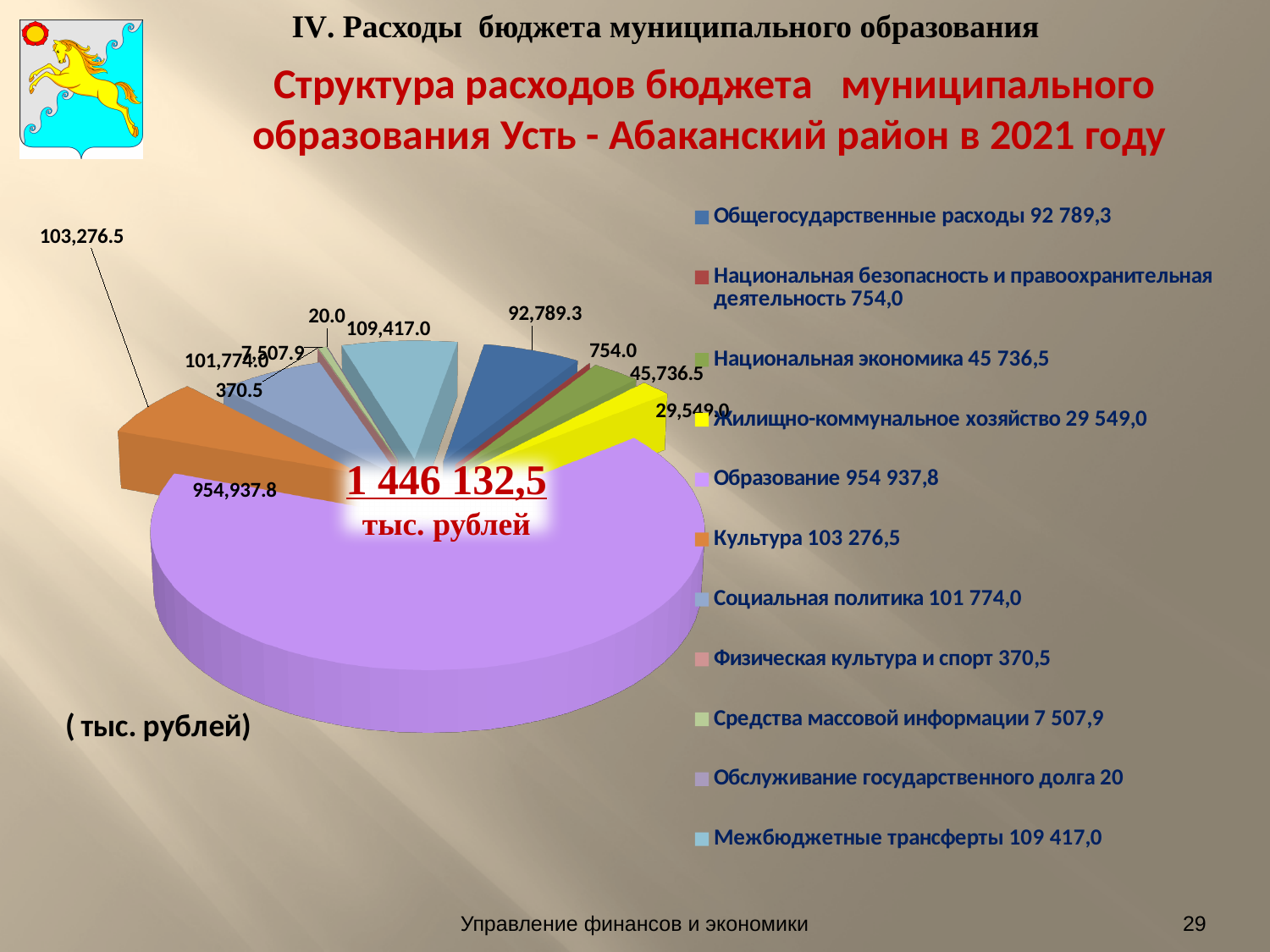
Which category has the largest slice of the pie chart? Образование What kind of chart is shown on the slide? Pie chart How many categories (slices) does the pie chart have? 11 What is the value for Образование in the pie chart? 954,937.8 What is the value for Межбюджетные трансферты in the pie chart? 109,417.0 What is the difference between the values for Межбюджетные трансферты and Общегосударственные расходы? 16,627.7 Which category has the smallest value in the pie chart? Обслуживание государственного долга What is the value for Национальная экономика in the pie chart? 45,736.5 What total amount is printed in the centre of the pie chart? 1 446 132,5 тыс. рублей Which is larger: the value for Жилищно-коммунальное хозяйство or the value for Национальная экономика? Национальная экономика What is the difference between the values for Культура and Социальная политика? 1,502.5 What is the value for Физическая культура и спорт in the pie chart? 370.5